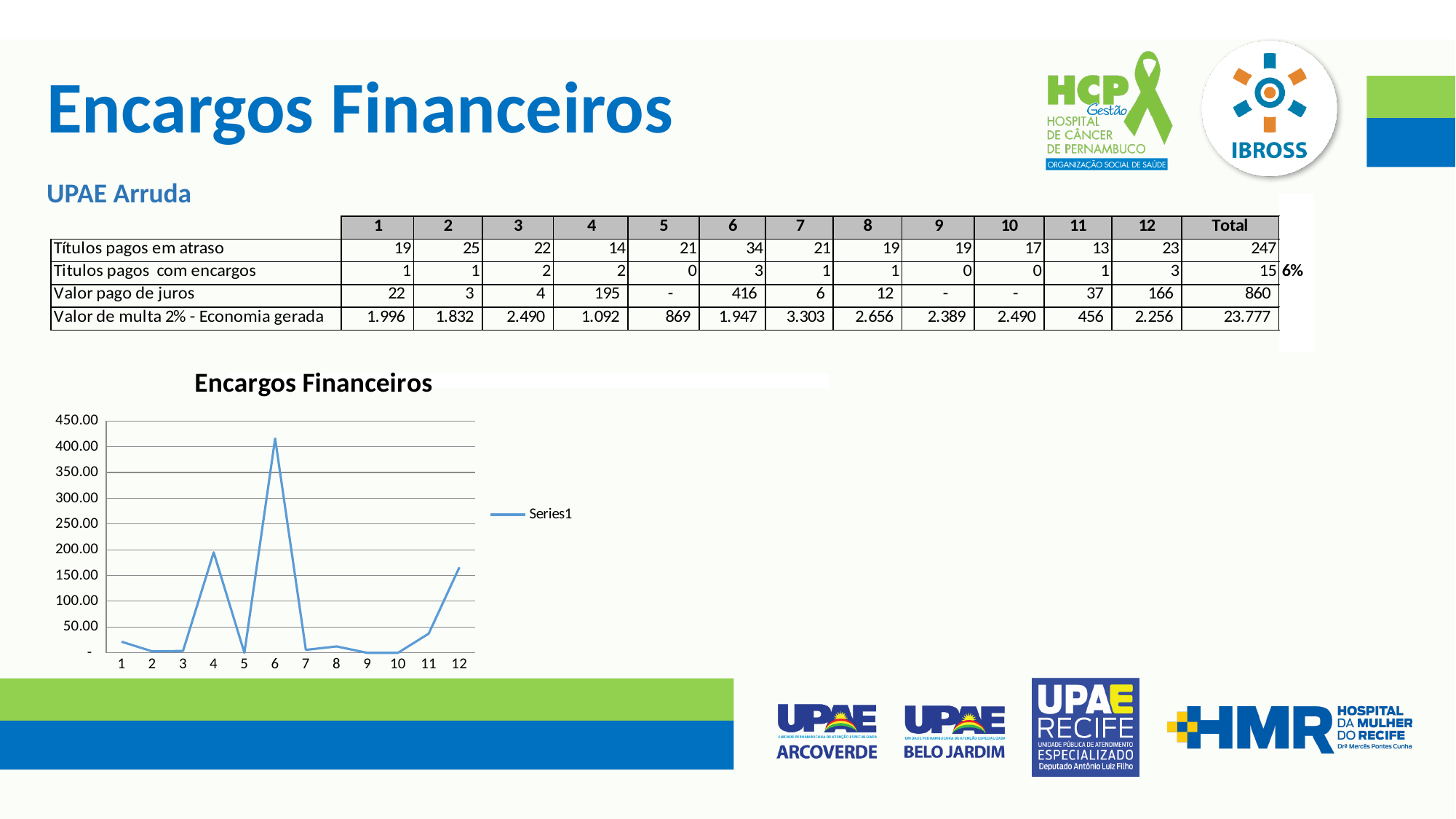
How many series does the chart legend list? 1 Does the line rise or fall from category 10 to category 12? rise Is the value at category 1 greater or less than 50? less What kind of chart is shown on the slide? line chart At which x-axis category does the line reach its highest value? 6 Which has the larger value, category 6 or category 4? 6 Is the value at category 4 greater or less than 150? greater What is the name of the series shown in the chart legend? Series1 What is the title of the chart? Encargos Financeiros How many points are plotted along the x axis of the chart? 12 Is the value at category 12 greater or less than 100? greater